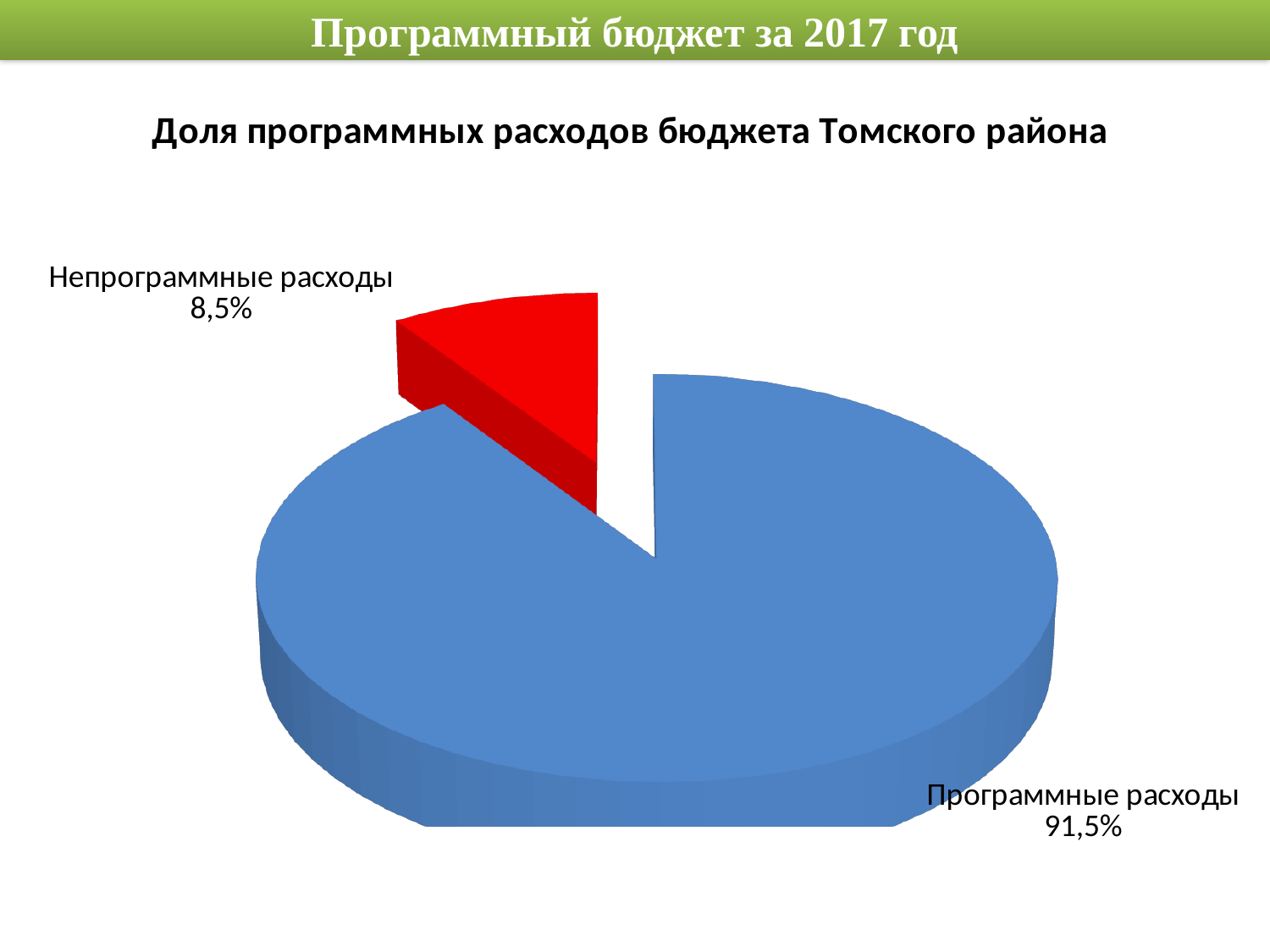
What is the title of the chart? Доля программных расходов бюджета Томского района How many slices does the pie chart have? 2 Which is larger: the share of Программные расходы or the share of Непрограммные расходы? Программные расходы What kind of chart is shown on the slide? pie chart What is the share for Непрограммные расходы? 8,5% What is the difference in percentage points between Программные расходы and Непрограммные расходы? 83 percentage points Which category has the largest slice of the pie? Программные расходы What is the total of the two slices shown? 100% What colour is the slice for Непрограммные расходы? red What is the share for Программные расходы? 91,5% Which category has the smallest slice of the pie? Непрограммные расходы